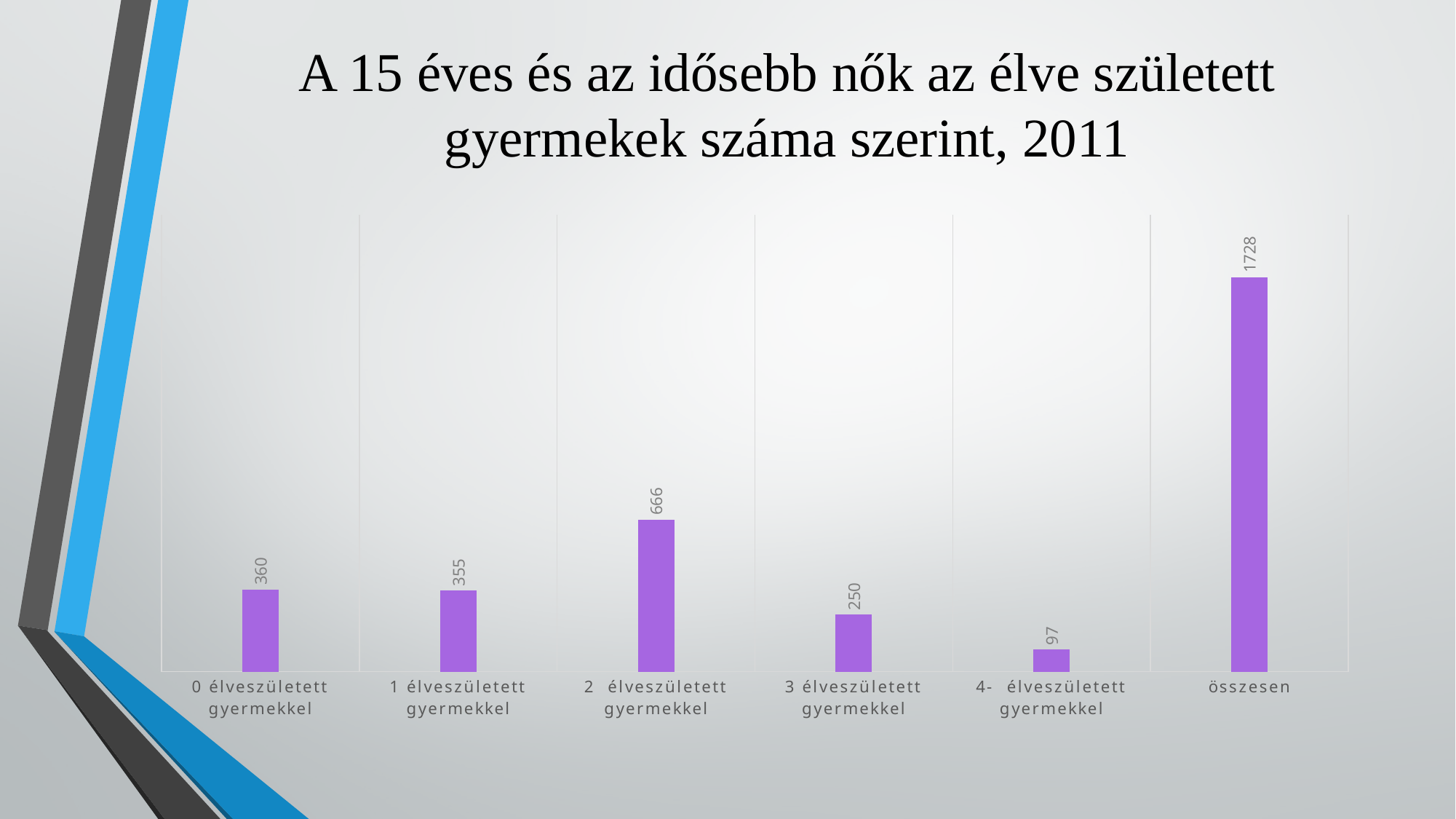
Which category has the lowest value? 4- élveszületett gyermekkel Which category has the highest value? összesen How many categories are shown on the x axis of the chart? 6 What is the title of the slide containing the chart? A 15 éves és az idősebb nők az élve született gyermekek száma szerint, 2011 What is the value for "0 élveszületett gyermekkel"? 360 What kind of chart is shown on the slide? bar chart What is the difference between the values for "2 élveszületett gyermekkel" and "1 élveszületett gyermekkel"? 311 What is the value for "4- élveszületett gyermekkel"? 97 What is the value for "összesen"? 1728 Which is larger, the value for "2 élveszületett gyermekkel" or the value for "3 élveszületett gyermekkel"? 2 élveszületett gyermekkel What is the difference between the values for "3 élveszületett gyermekkel" and "4- élveszületett gyermekkel"? 153 What is the value for "2 élveszületett gyermekkel"? 666